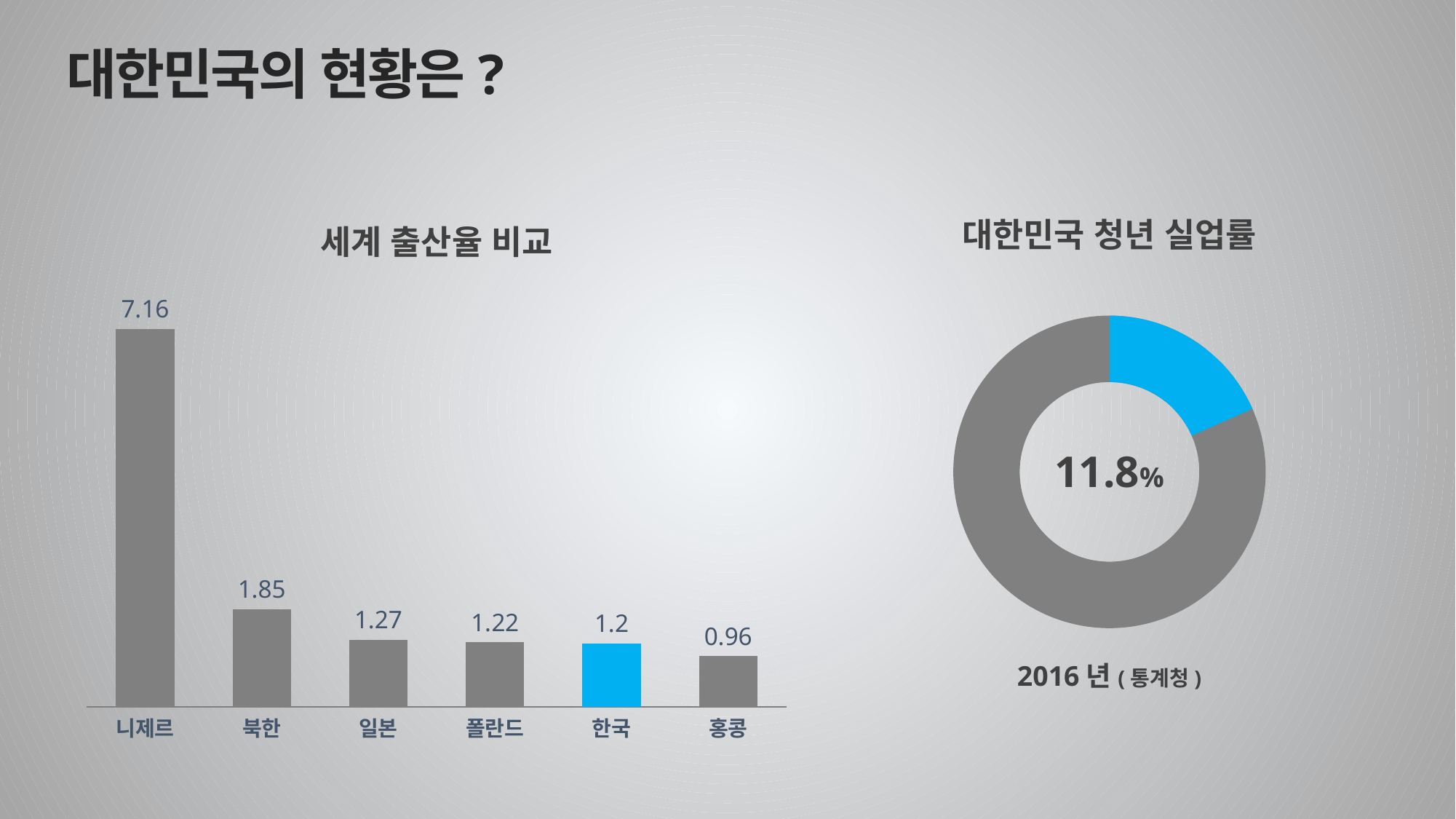
What percentage is shown in the center of the '대한민국 청년 실업률' chart? 11.8% In the '세계 출산율 비교' chart, what is the difference between the values for 일본 and 한국? 0.07 How many categories are shown in the '세계 출산율 비교' chart? 6 In the '세계 출산율 비교' chart, what is the value for 홍콩? 0.96 In the '세계 출산율 비교' chart, what is the value for 한국? 1.2 In the '세계 출산율 비교' chart, what is the difference between the values for 니제르 and 북한? 5.31 In the '세계 출산율 비교' chart, which bar is highlighted in blue? 한국 What kind of chart is the '세계 출산율 비교' chart? bar chart In the '세계 출산율 비교' chart, which is larger, the value for 북한 or the value for 일본? 북한 In the '세계 출산율 비교' chart, which category has the lowest value? 홍콩 In the '세계 출산율 비교' chart, what is the value for 니제르? 7.16 In the '세계 출산율 비교' chart, which category has the highest value? 니제르